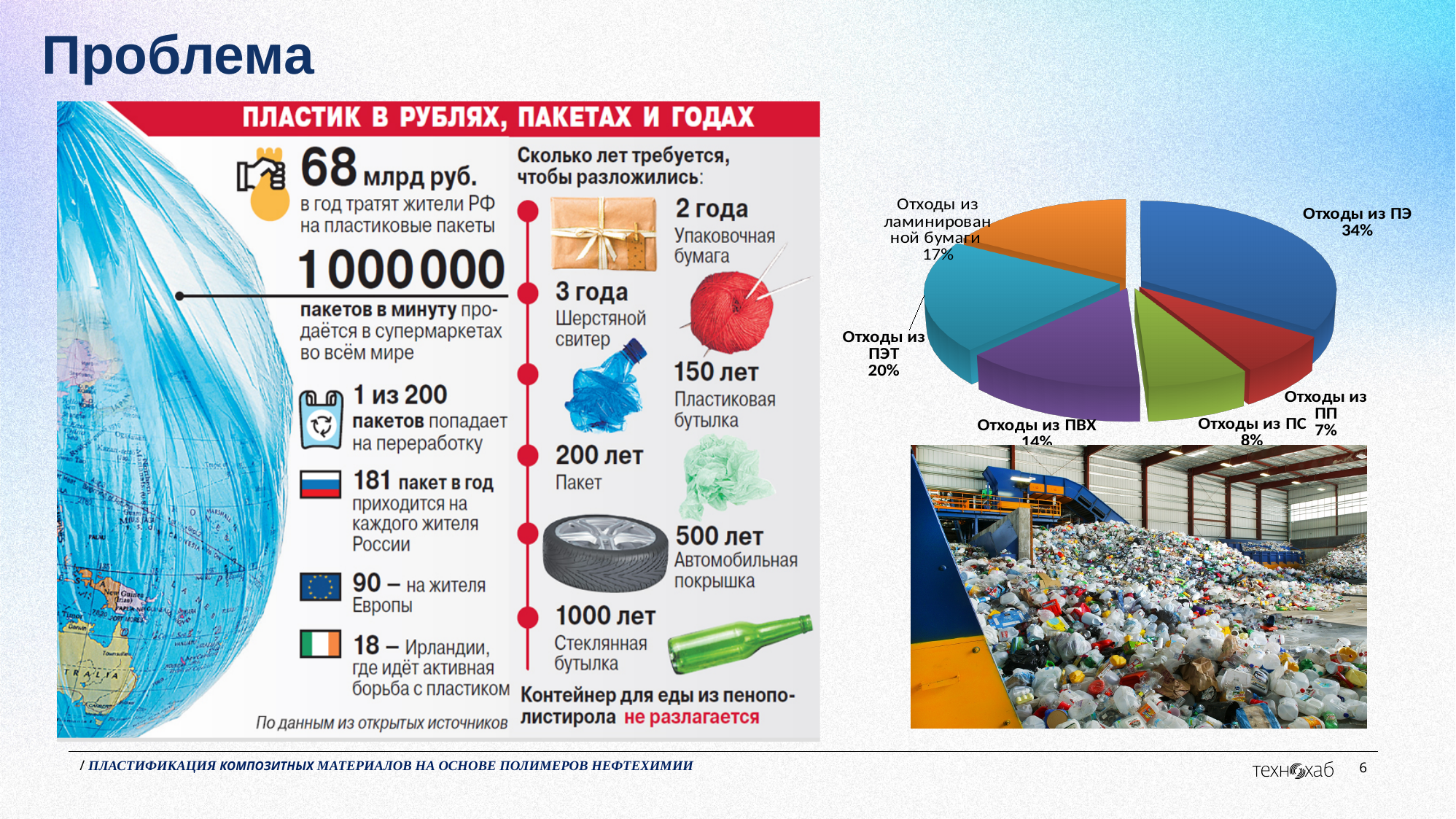
What share of the pie chart is labelled "Отходы из ламинированной бумаги"? 17% What share of the pie chart is labelled "Отходы из ПП"? 7% What share of the pie chart is labelled "Отходы из ПС"? 8% Which category has the smallest slice in the pie chart? Отходы из ПП What share of the pie chart is labelled "Отходы из ПВХ"? 14% What kind of chart is shown on the right side of the slide? Pie chart What is the difference in percentage points between the "Отходы из ПЭ" slice and the "Отходы из ПЭТ" slice? 14 percentage points What share of the pie chart is labelled "Отходы из ПЭ"? 34% What share of the pie chart is labelled "Отходы из ПЭТ"? 20% Which slice is larger in the pie chart: "Отходы из ПВХ" or "Отходы из ПС"? Отходы из ПВХ How many slices does the pie chart have? 6 Which category has the largest slice in the pie chart? Отходы из ПЭ